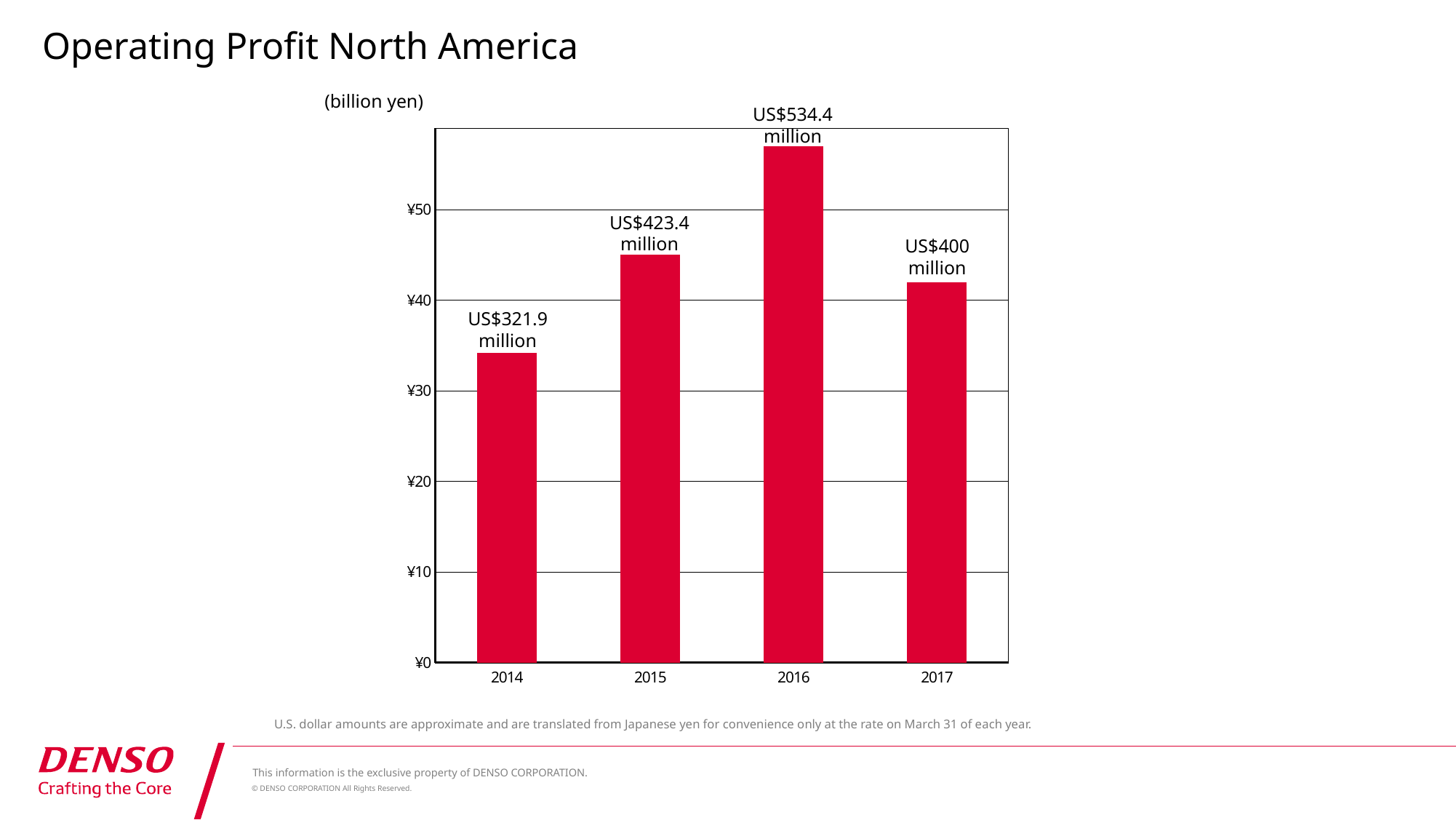
What kind of chart is shown on the slide? Bar chart How many years are shown on the chart? 4 What unit is stated for the vertical axis of the chart? billion yen Which year has the larger operating profit, 2015 or 2017? 2015 Which year has the lowest operating profit? 2014 Is the operating profit for 2016 greater or less than ¥50 billion? greater Is the operating profit for 2015 greater or less than ¥40 billion? greater Which year has the highest operating profit? 2016 Is the operating profit for 2014 greater or less than ¥40 billion? less What US dollar amount is labelled on the bar for 2016? US$534.4 million What US dollar amount is labelled on the bar for 2017? US$400 million What US dollar amount is labelled on the bar for 2014? US$321.9 million